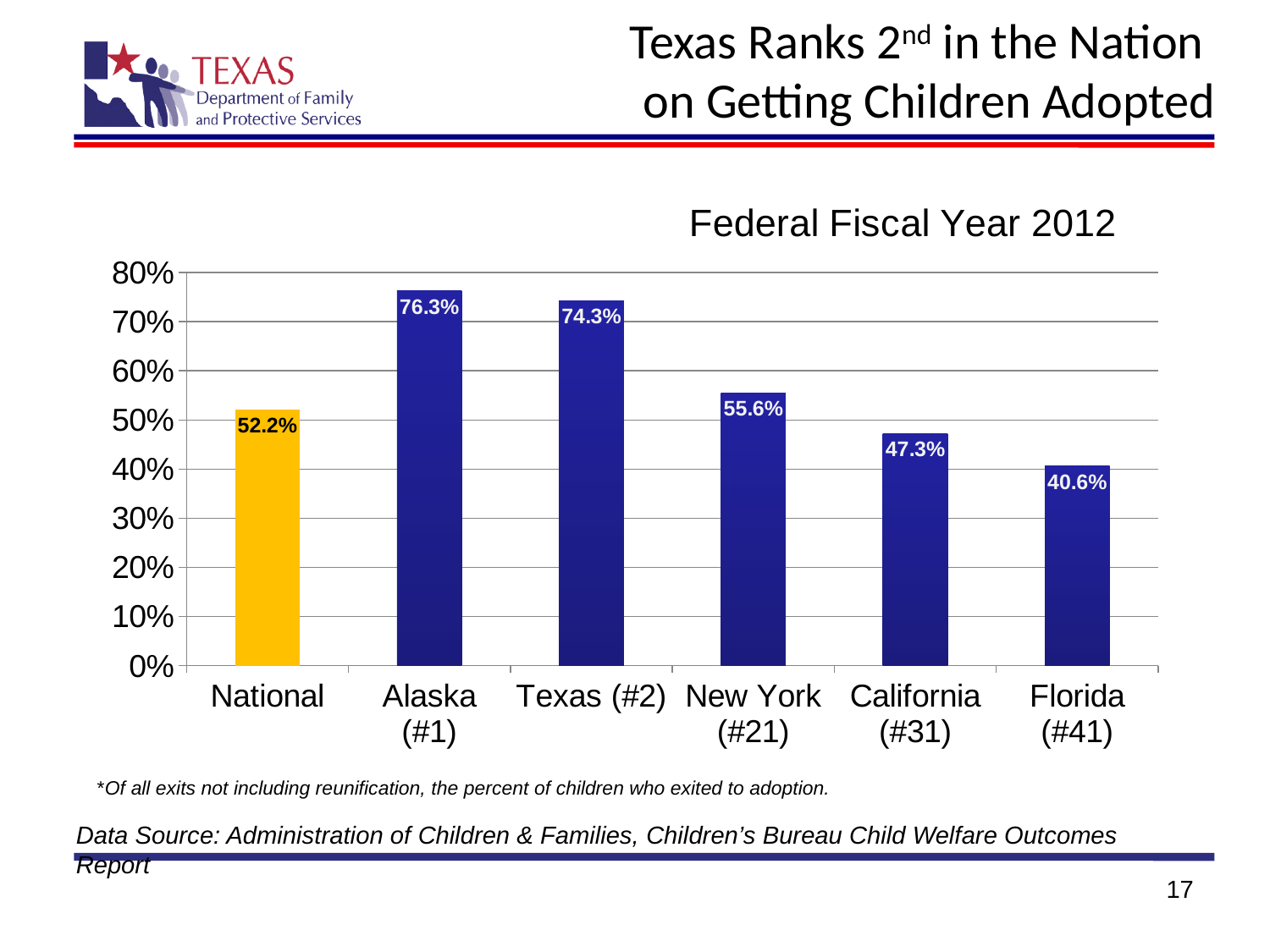
Which bar is shown in a different colour (yellow) from the others? National Which category has the lowest value? Florida (#41) Which is larger, the value for New York (#21) or California (#31)? New York (#21) What is the value for Texas (#2)? 74.3% What is the difference between the values for Alaska (#1) and Texas (#2)? 2.0% What kind of chart is shown on the slide? bar chart How many categories are shown on the x axis? 6 Which category has the highest value? Alaska (#1) What is the value for the National bar? 52.2% What is the difference between the values for Texas (#2) and the National bar? 22.1% Is the value for California (#31) greater or less than 50%? less What is the value for Florida (#41)? 40.6%